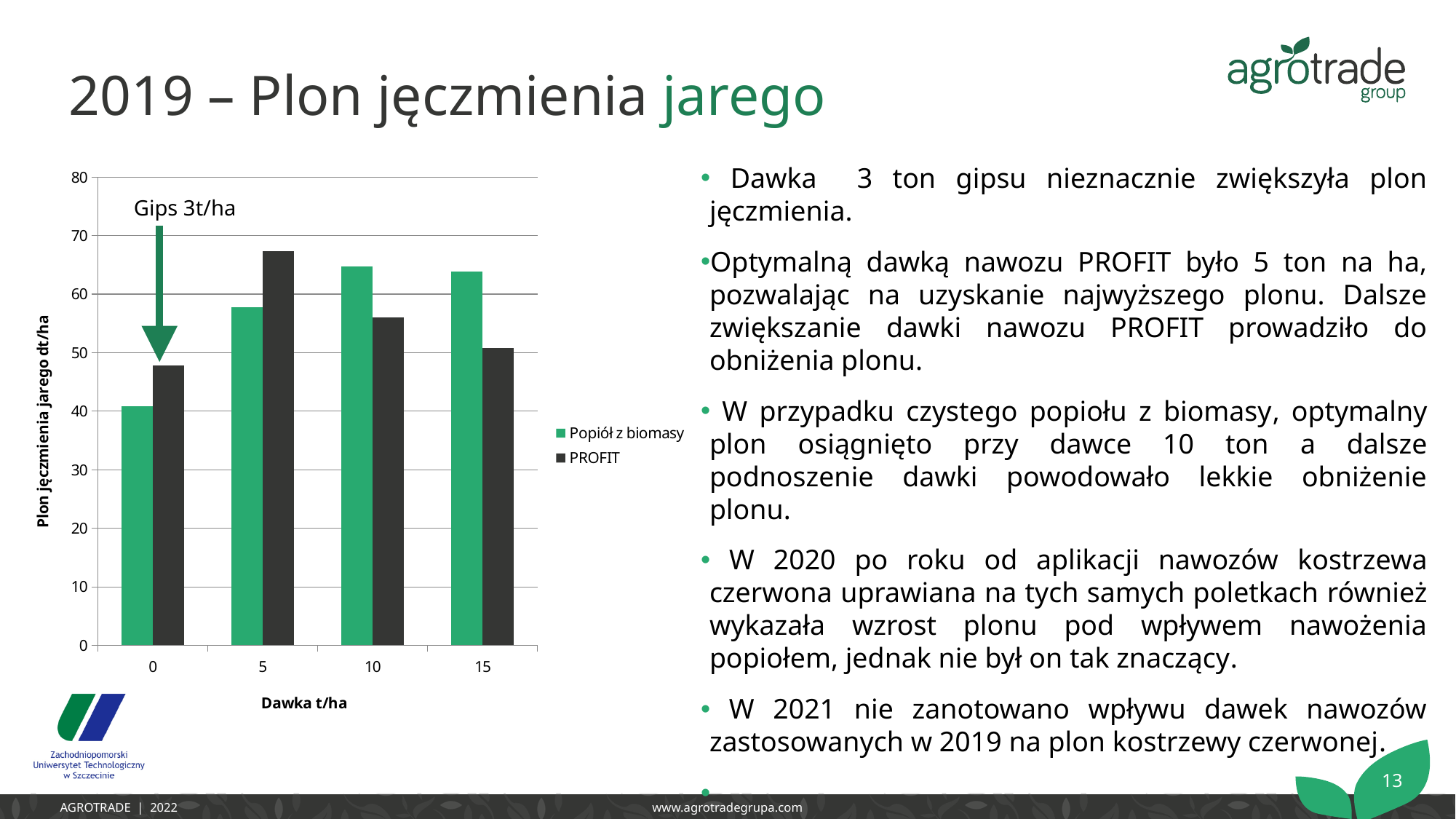
Is the value for Popiół z biomasy at dose 0 greater or less than 50? less At dose 10, which series has the larger value: Popiół z biomasy or PROFIT? Popiół z biomasy Is the value for PROFIT at dose 15 greater or less than 60? less How many series does the chart legend list? 2 Is the value for PROFIT at dose 5 greater or less than 60? greater What is the title of the chart's y axis? Plon jęczmienia jarego dt/ha Do the PROFIT values rise or fall as the dose increases from 5 to 15 t/ha? fall At dose 0, which series has the larger value: Popiół z biomasy or PROFIT? PROFIT How many dose categories are shown on the x axis of the chart? 4 What kind of chart is shown on the slide? bar chart At which dose (Dawka t/ha) is the Popiół z biomasy bar lowest? 0 At which dose (Dawka t/ha) is the PROFIT bar highest? 5